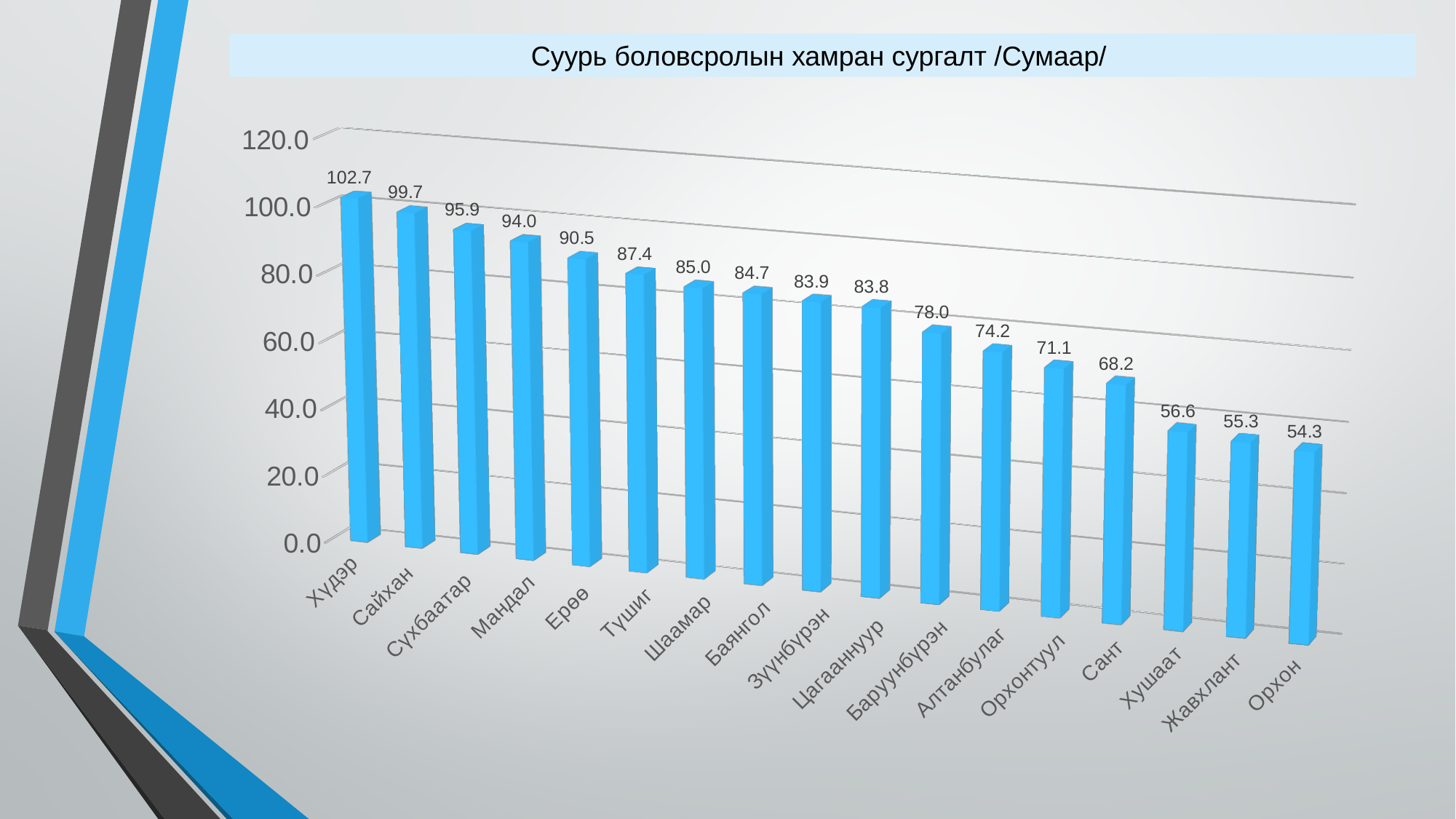
What is the title of the chart? Суурь боловсролын хамран сургалт /Сумаар/ How many categories are shown on the x axis? 17 What is the value for Сант? 68.2 What is the value for Хүдэр? 102.7 What is the difference between the values for Мандал and Ерөө? 3.5 Is the value for Хушаат greater or less than 60.0? less What is the difference between the values for Хүдэр and Орхон? 48.4 What is the value for Баруунбүрэн? 78.0 Which category has the highest value? Хүдэр What kind of chart is shown on the slide? bar chart Which category has the lowest value? Орхон Which is larger, the value for Алтанбулаг or the value for Орхонтуул? Алтанбулаг